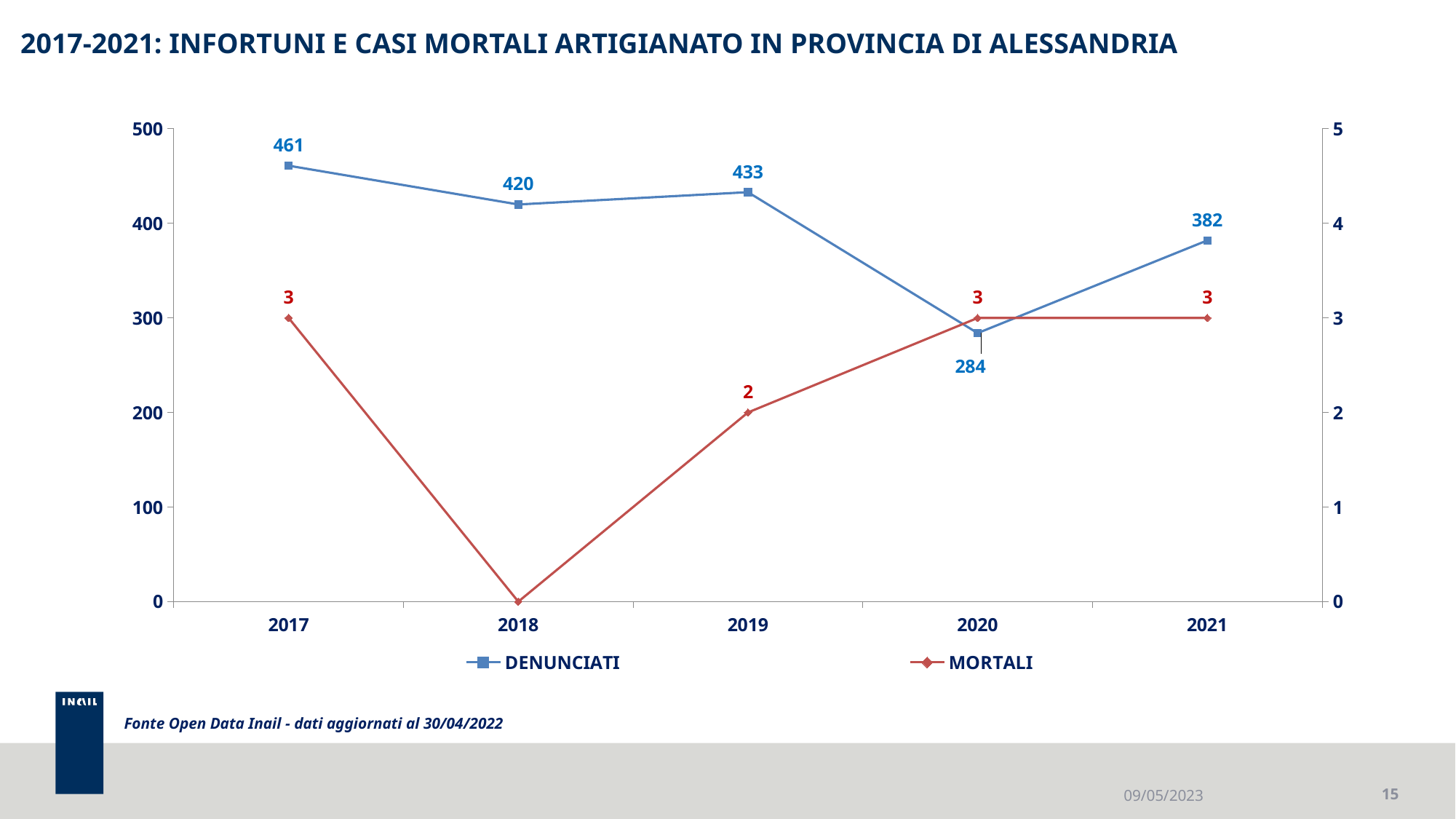
How many years are shown on the x axis? 5 What is the MORTALI value for 2019? 2 What kind of chart is shown on the slide? Line chart How many series does the legend list? 2 What is the DENUNCIATI value for 2020? 284 Does the DENUNCIATI series rise or fall from 2019 to 2020? Fall In which year is the DENUNCIATI value lowest? 2020 What is the DENUNCIATI value for 2017? 461 In which year is the DENUNCIATI value highest? 2017 Which year has a larger DENUNCIATI value, 2018 or 2019? 2019 In which year is the MORTALI value lowest? 2018 What is the difference between the DENUNCIATI values for 2017 and 2021? 79